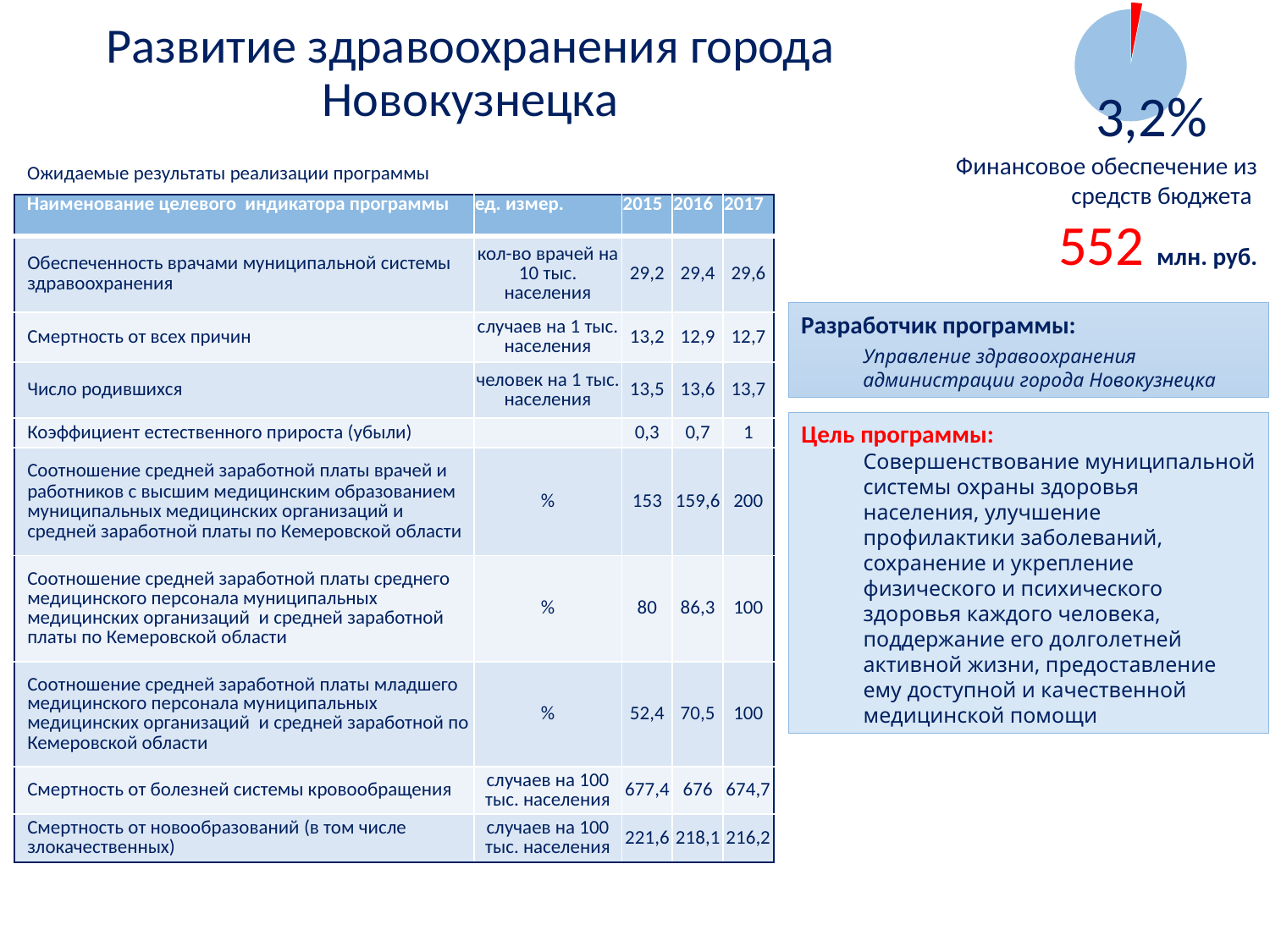
What colour is the small slice of the pie chart? red How many slices does the pie chart have? 2 What caption appears directly below the pie chart? Финансовое обеспечение из средств бюджета Which slice of the pie chart is larger, the red one or the blue one? the blue one What share of the pie chart does the small red slice represent? 3,2% What percentage is printed on the pie chart in the top right corner? 3,2% What kind of chart is shown in the top right corner of the slide? pie chart